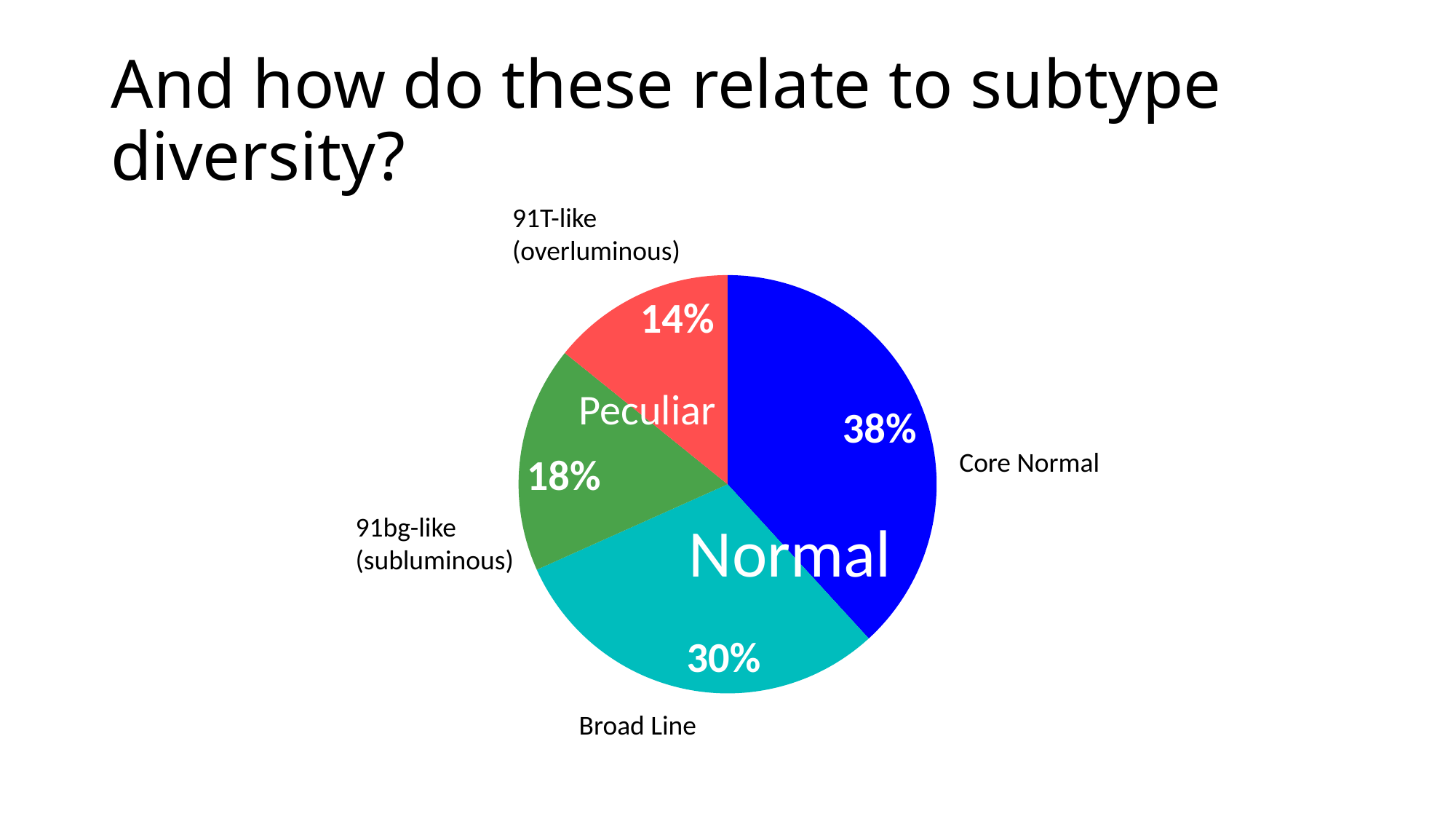
What is the difference in percentage points between Core Normal and Broad Line? 8 What share of the pie does Broad Line have? 30% How many slices does the pie chart have? 4 What is the combined share of the Core Normal and Broad Line slices? 68% What share of the pie does Core Normal have? 38% Which slice of the pie is the largest? Core Normal Which slice of the pie is the smallest? 91T-like (overluminous) What kind of chart is shown on the slide? Pie chart Which two group labels are written across the pie to group the slices? Normal and Peculiar Which is larger, the 91bg-like (subluminous) slice or the 91T-like (overluminous) slice? 91bg-like (subluminous) What share of the pie does 91T-like (overluminous) have? 14%